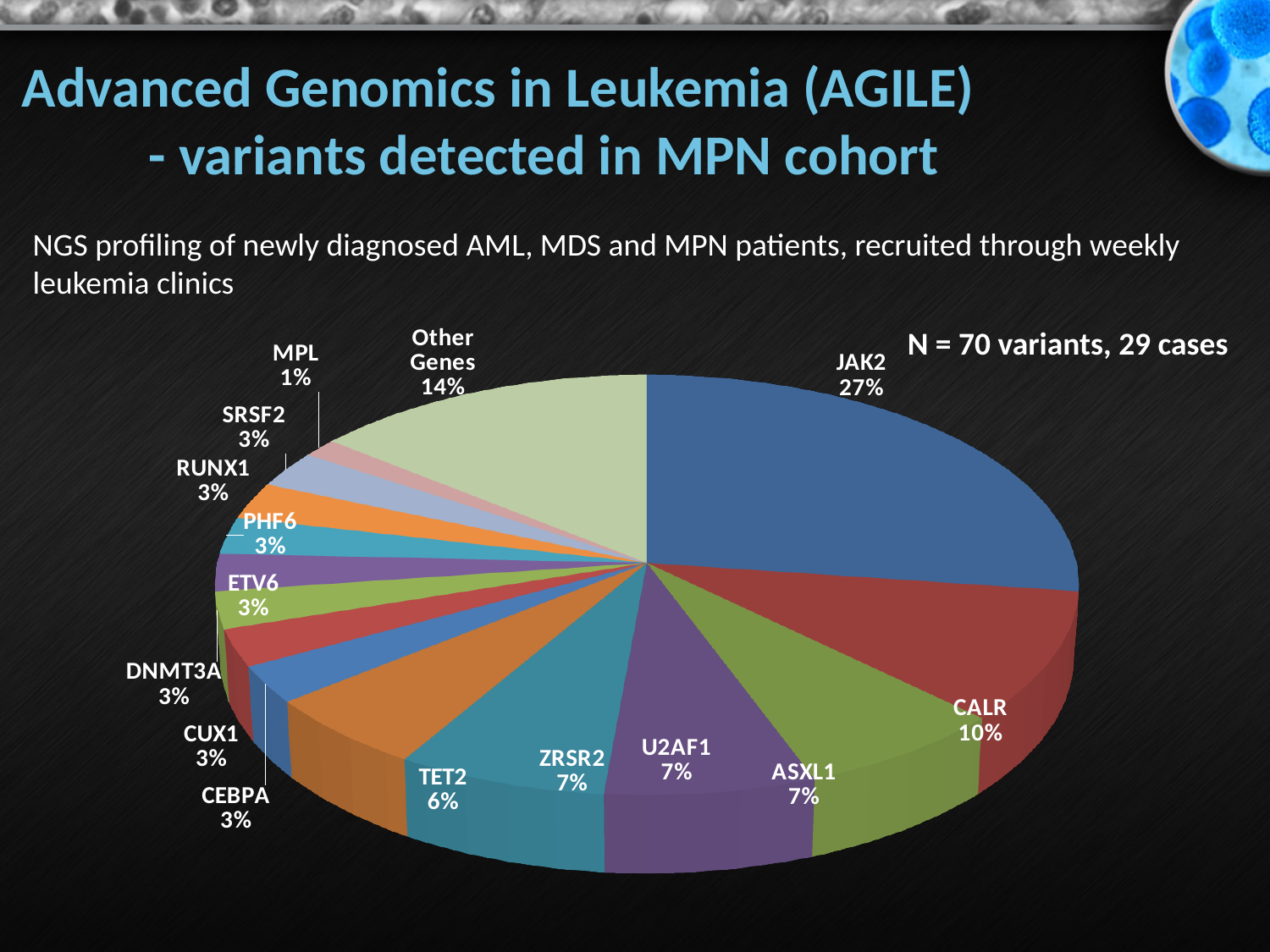
Which gene has the largest slice of the pie? JAK2 What percentage is shown for CALR? 10% What percentage is shown for TET2? 6% According to the annotation on the chart, how many variants and cases are represented? N = 70 variants, 29 cases What percentage is shown for MPL? 1% How many slices does the pie chart have? 15 Which is larger, the share for Other Genes or the share for CALR? Other Genes Which gene has the smallest slice of the pie? MPL What percentage is shown for Other Genes? 14% What kind of chart is shown on the slide? Pie chart What share of the pie does JAK2 account for? 27% What is the difference in percentage points between JAK2 and CALR? 17